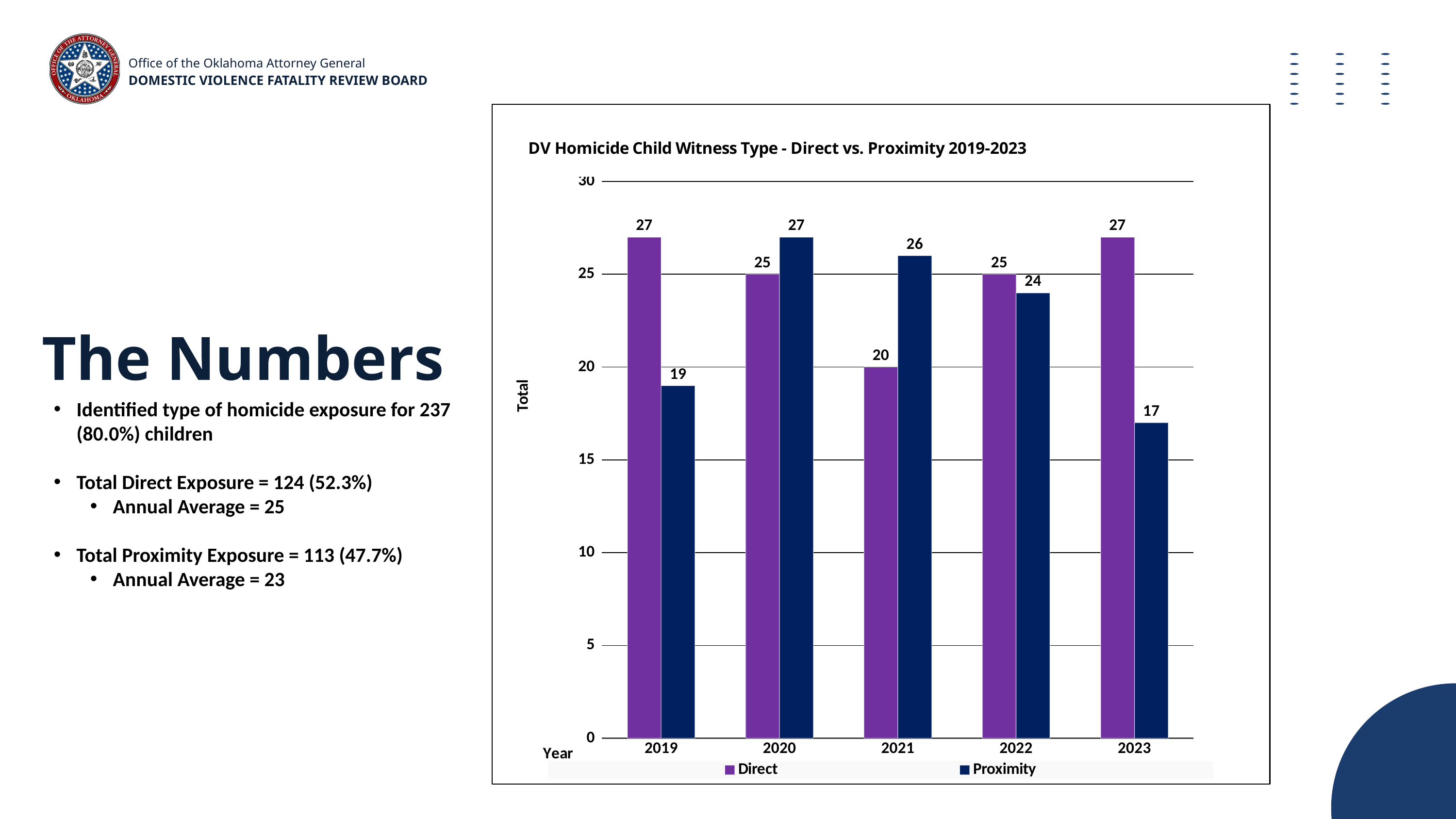
What is the Proximity value for 2023? 17 What is the Direct value for 2019? 27 What is the difference between the Direct and Proximity values in 2023? 10 How many series does the legend list? 2 Which year has the lowest Direct value? 2021 How many years are shown on the x axis? 5 What kind of chart is shown on the slide? Bar chart What is the difference between the Direct and Proximity values in 2021? 6 In 2019, which is larger, Direct or Proximity? Direct What is the Proximity value for 2021? 26 In 2020, which is larger, Direct or Proximity? Proximity Which year has the lowest Proximity value? 2023